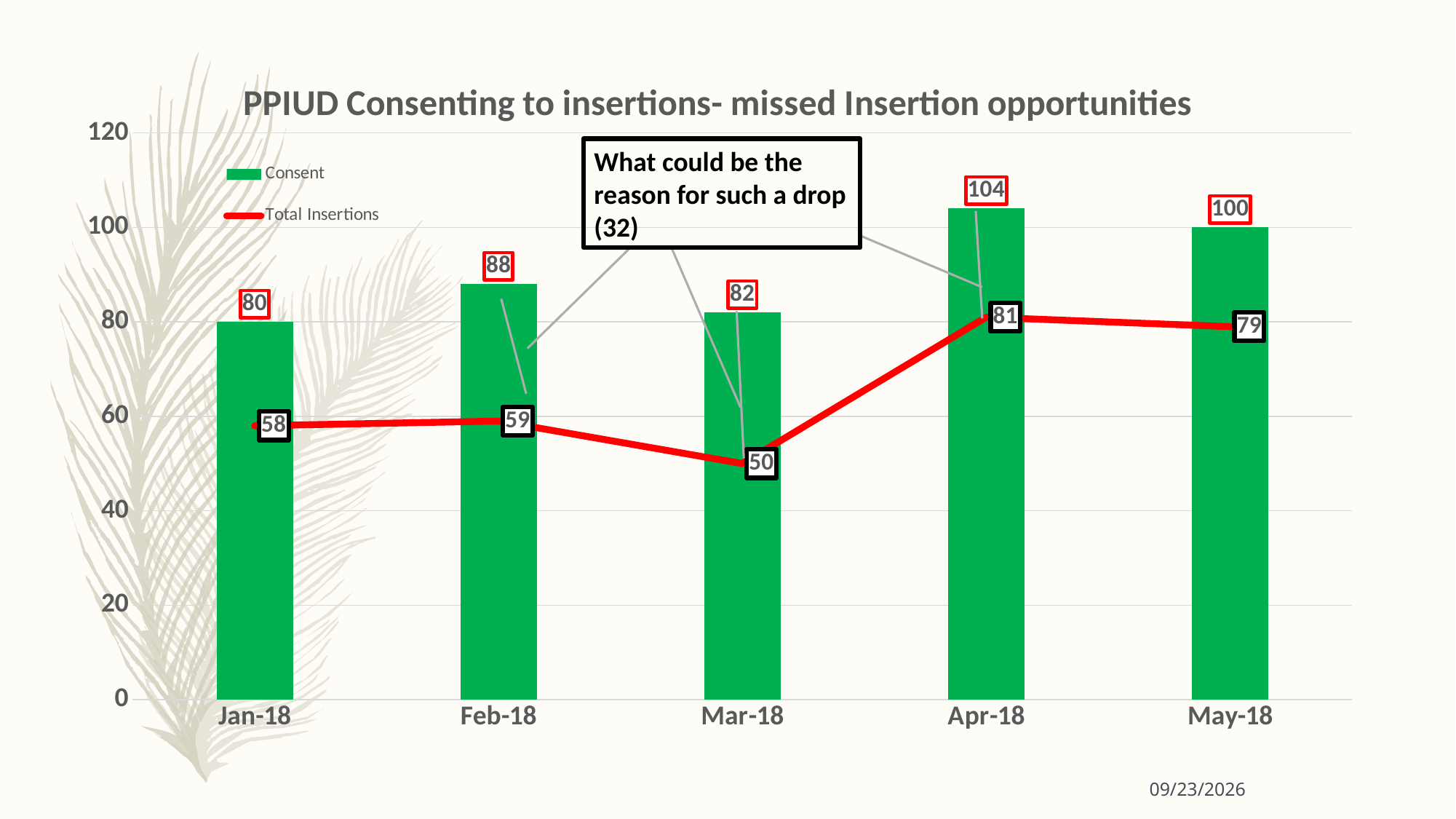
What is the Consent value for Apr-18? 104 How many series does the legend list? 2 Which is larger, the Consent value for Feb-18 or the Consent value for Mar-18? Feb-18 What is the difference between Consent and Total Insertions in Mar-18? 32 What is the title of the chart? PPIUD Consenting to insertions- missed Insertion opportunities Which month has the highest Consent value? Apr-18 How many months are shown on the x axis? 5 Does the Total Insertions value rise or fall from Feb-18 to Mar-18? fall Which month has the lowest Total Insertions value? Mar-18 What is the Total Insertions value for Mar-18? 50 What kinds of chart are combined on this slide? Bar chart and line chart Is the Total Insertions value for Apr-18 greater or less than 60? greater